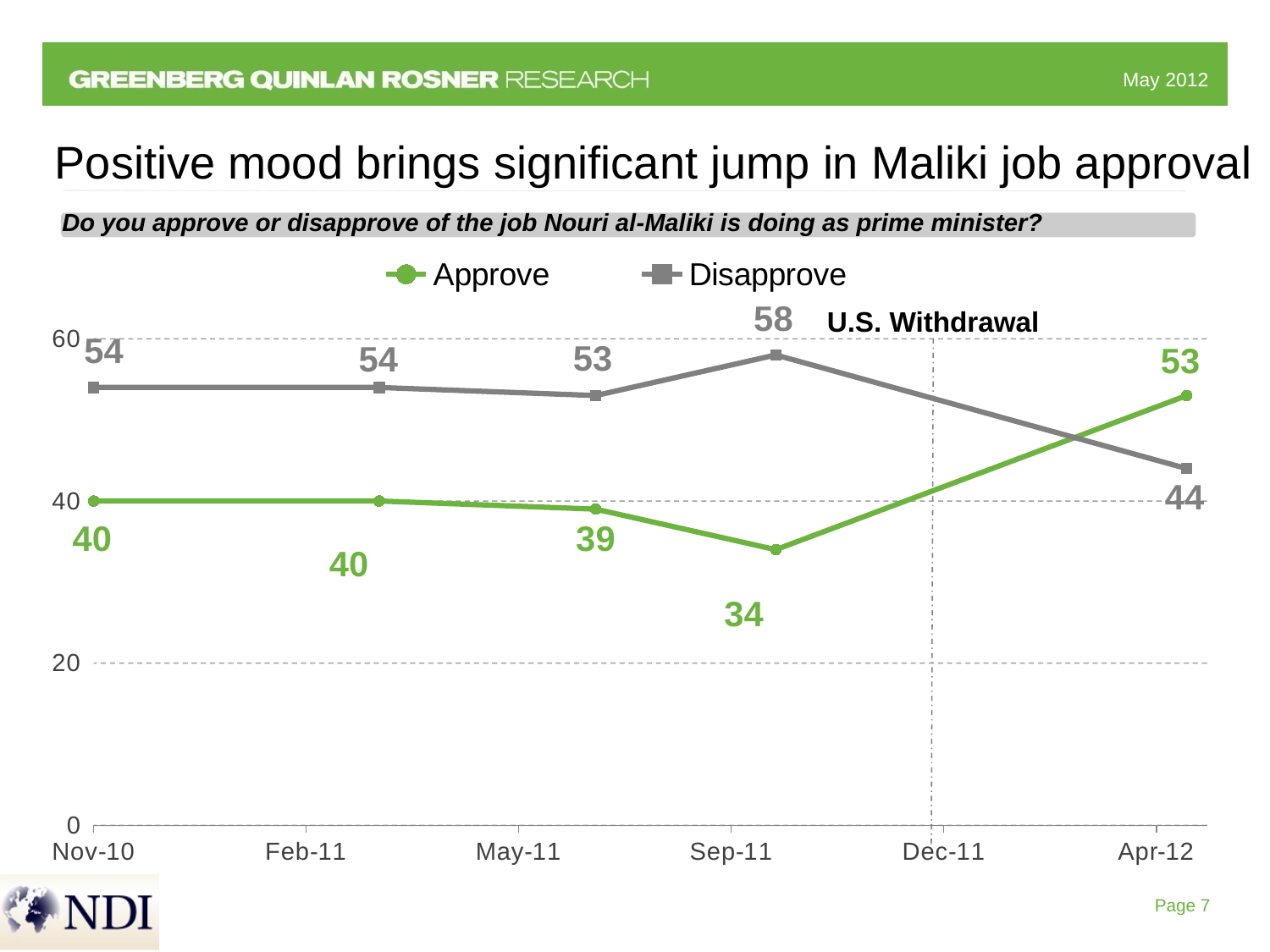
At the last point (Apr-12), which is larger, Approve or Disapprove? Approve What is the Disapprove value at the last point (Apr-12)? 44 How many data points are plotted for the Approve series? 5 What are the two series named in the legend? Approve and Disapprove What is the Approve value at the last point (Apr-12)? 53 How many series does the legend list? 2 What is the difference between the Disapprove value (54) and the Approve value (40) at the first point (Nov-10)? 14 What is the highest value reached by the Disapprove series? 58 What is the Approve value at the first point (Nov-10)? 40 What kind of chart is shown on the slide? line chart What is the lowest value reached by the Approve series? 34 Does the Approve series rise or fall between its fourth point (34) and its last point (53)? rise